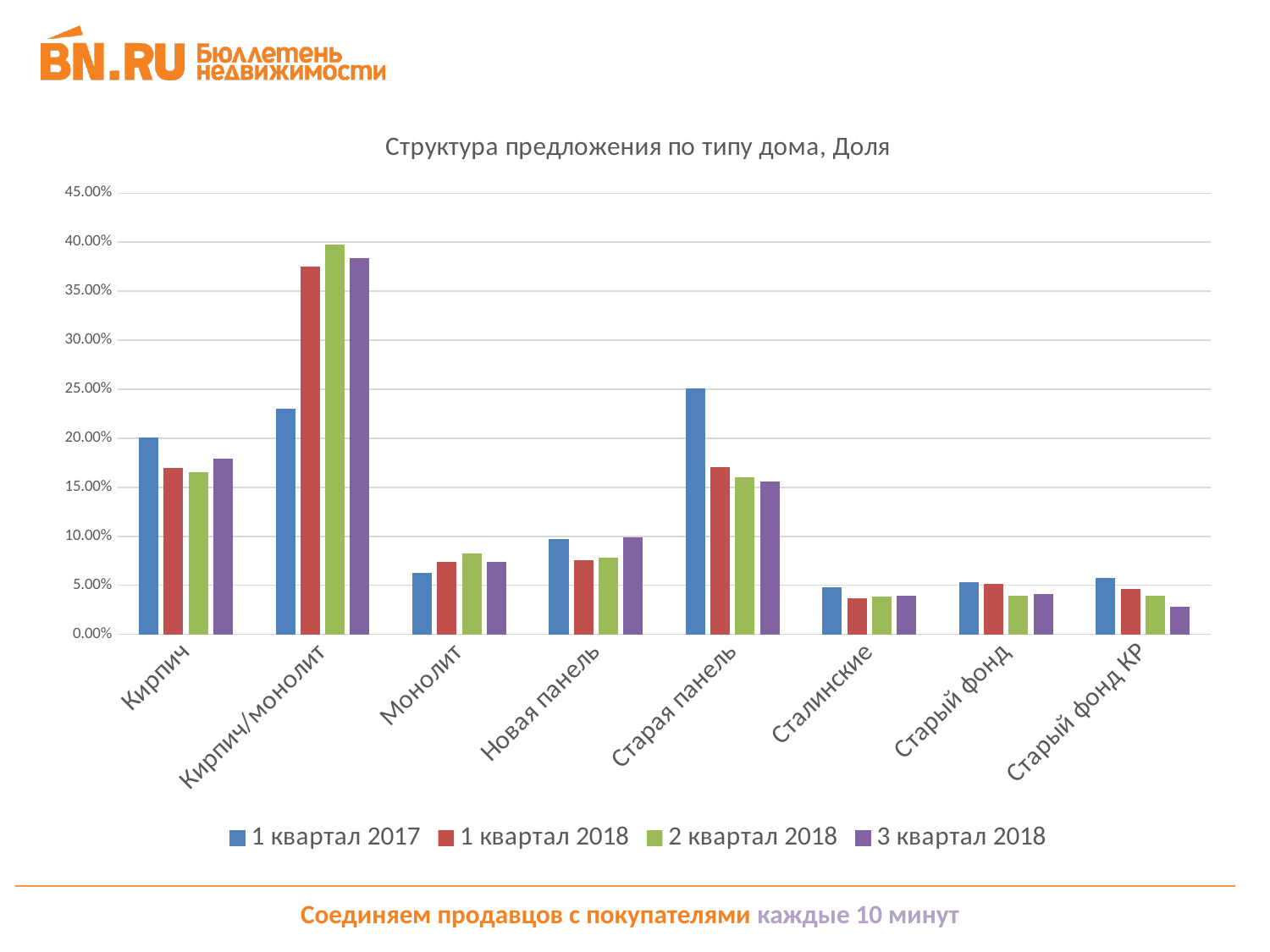
For Кирпич, which is larger: the value for 1 квартал 2017 or for 3 квартал 2018? 1 квартал 2017 Which category has the lowest value for 3 квартал 2018? Старый фонд КР What is the title of the chart? Структура предложения по типу дома, Доля Is the value for Монолит in 1 квартал 2017 greater or less than 10.00%? less How many house-type categories are shown on the x axis? 8 What kind of chart is shown on the slide? Bar chart How many series does the legend list? 4 Is the value for Кирпич/монолит in 2 квартал 2018 greater or less than 35.00%? greater For 1 квартал 2017, which is larger: the value for Старая панель or for Кирпич/монолит? Старая панель Which category has the highest value for 2 квартал 2018? Кирпич/монолит Which category has the highest value for 1 квартал 2017? Старая панель Is the value for Старая панель in 1 квартал 2017 greater or less than 20.00%? greater